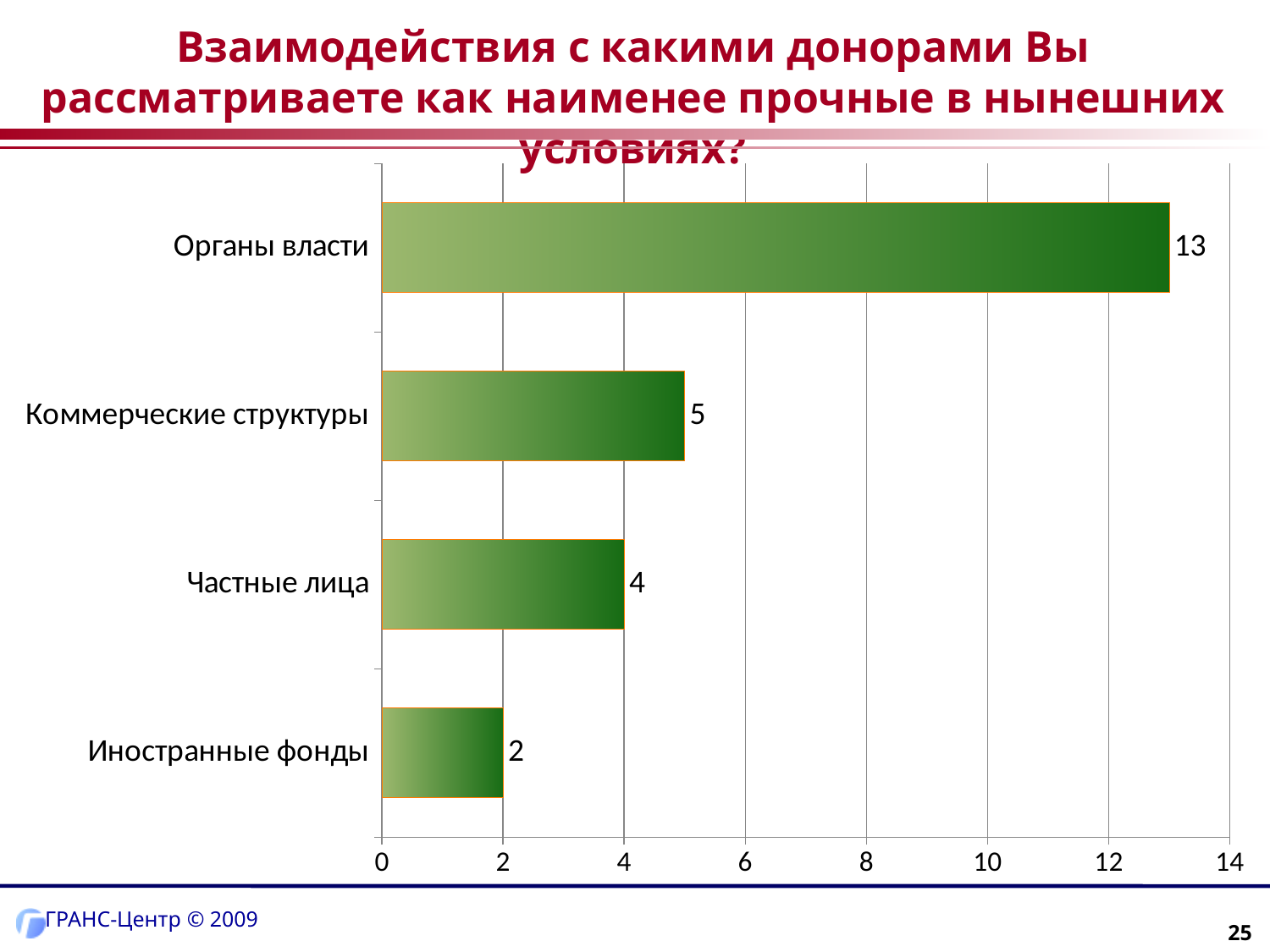
Is the value for Органы власти greater or less than 12? greater What is the difference between the values for Органы власти and Коммерческие структуры? 8 How many categories are shown in the chart? 4 What is the value for Органы власти? 13 What is the value for Частные лица? 4 Which category has the highest value? Органы власти Which is larger, the value for Коммерческие структуры or the value for Частные лица? Коммерческие структуры What is the value for Иностранные фонды? 2 What kind of chart is shown on the slide? bar chart Which category has the lowest value? Иностранные фонды What is the difference between the values for Частные лица and Иностранные фонды? 2 What is the value for Коммерческие структуры? 5